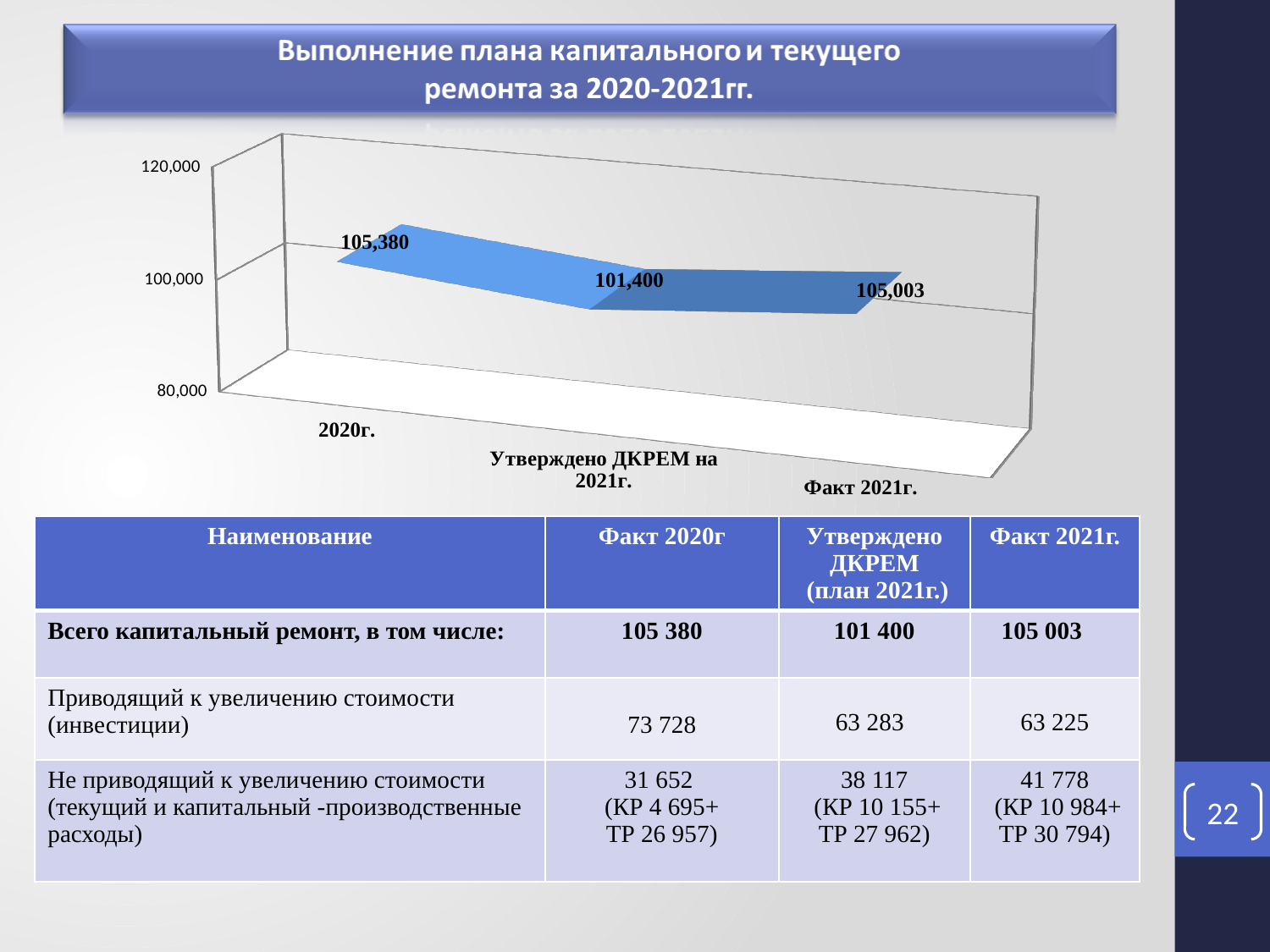
Which category has the highest value on the chart? 2020г. Which is larger, the value for 2020г. or the value for Факт 2021г.? 2020г. How many categories are plotted on the chart? 3 What is the highest tick value shown on the vertical axis of the chart? 120,000 What is the value plotted for 2020г.? 105,380 Which category has the lowest value on the chart? Утверждено ДКРЕМ на 2021г. What kind of chart is shown on the slide? 3D line chart Is the value for Утверждено ДКРЕМ на 2021г. greater or less than 100,000? greater What is the value plotted for Утверждено ДКРЕМ на 2021г.? 101,400 What is the difference between the value for 2020г. and the value for Утверждено ДКРЕМ на 2021г.? 3,980 What is the value plotted for Факт 2021г.? 105,003 What is the difference between the value for Факт 2021г. and the value for Утверждено ДКРЕМ на 2021г.? 3,603